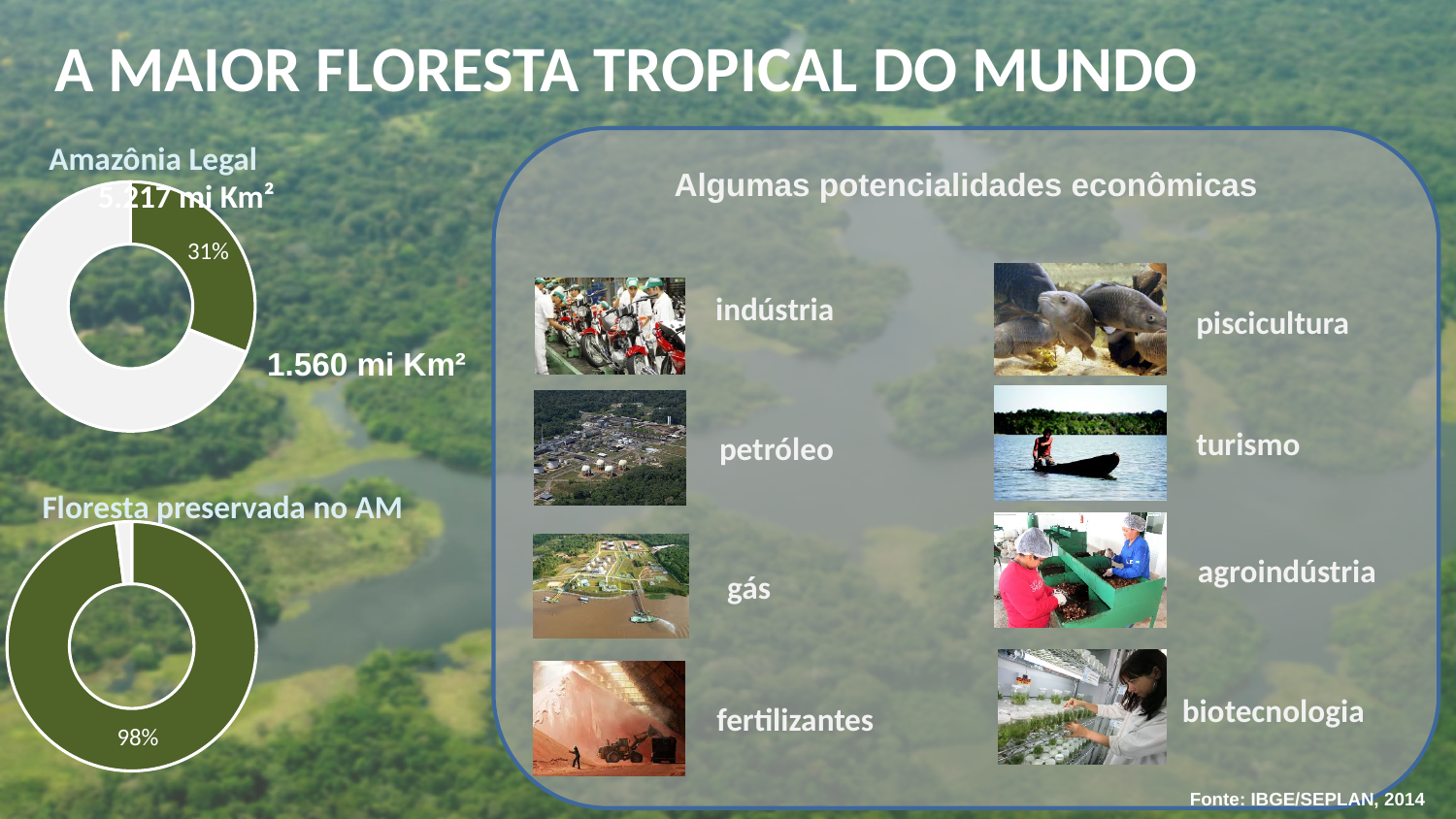
What kind of chart is used for 'Amazônia Legal' and 'Floresta preservada no AM'? doughnut chart What is the title of the bottom doughnut chart on the slide? Floresta preservada no AM In the top doughnut chart titled 'Amazônia Legal', what area value is labeled next to the dark green slice? 1.560 mi Km² What total area is shown in the title of the top doughnut chart? 5.217 mi Km² In the top doughnut chart titled 'Amazônia Legal', which slice is larger, the dark green slice or the light slice? the light slice In the bottom doughnut chart titled 'Floresta preservada no AM', which slice is larger, the dark green slice or the light slice? the dark green slice In the top doughnut chart titled 'Amazônia Legal', what share of the whole does the light (remaining) slice represent? 69% How many charts are shown on the slide? 2 In the bottom doughnut chart titled 'Floresta preservada no AM', what share of the whole does the light (remaining) slice represent? 2% In the bottom doughnut chart titled 'Floresta preservada no AM', what percentage is printed on the dark green slice? 98% In the top doughnut chart titled 'Amazônia Legal', what percentage is printed on the dark green slice? 31% How many slices does the top doughnut chart titled 'Amazônia Legal' have? 2